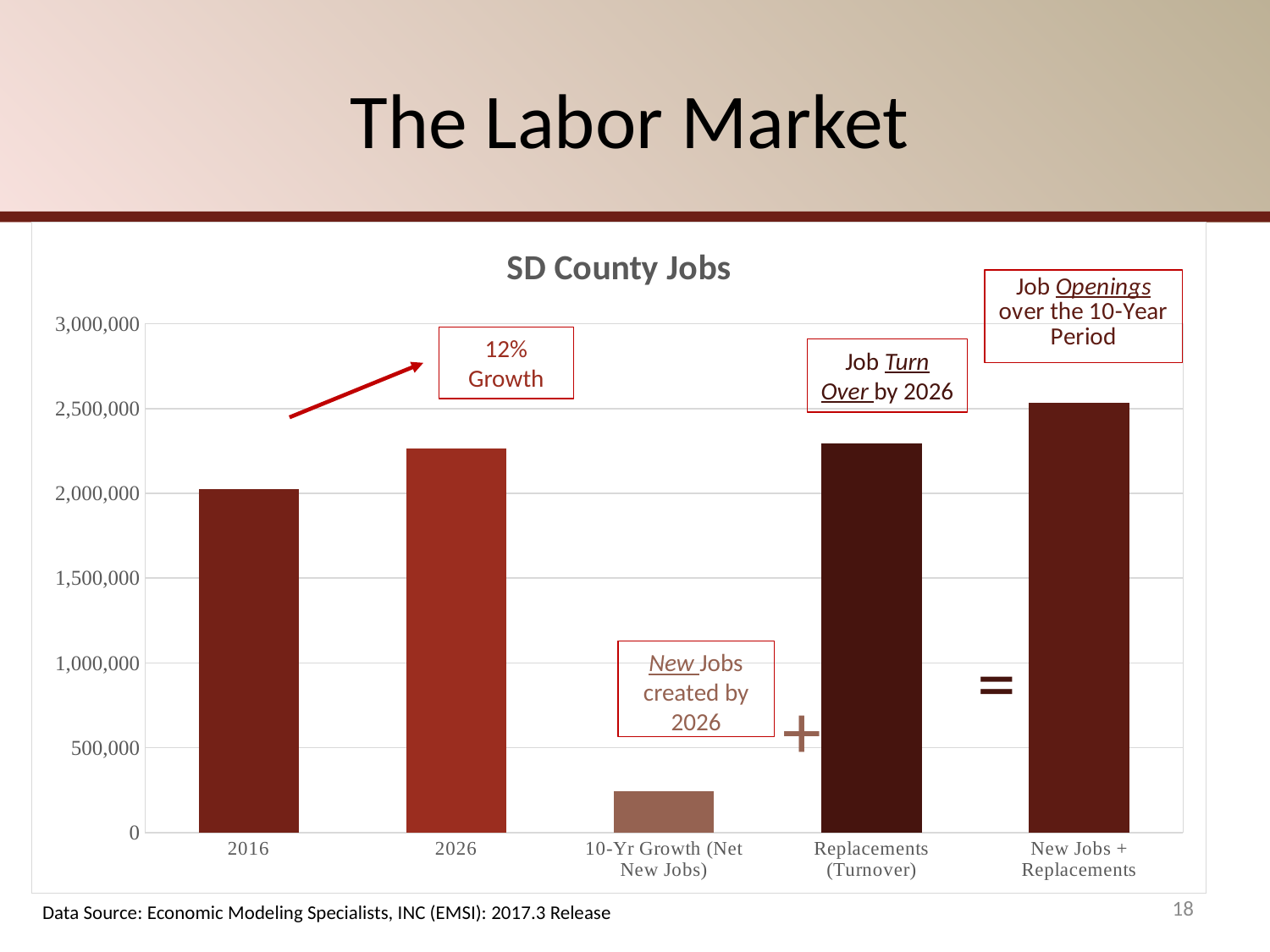
Is the value for 2026 greater or less than 2,500,000? less Is the value for 10-Yr Growth (Net New Jobs) greater or less than 500,000? less Which category has the highest value in the chart? New Jobs + Replacements What kind of chart is shown on the slide? bar chart What growth percentage does the annotation between the 2016 and 2026 bars state? 12% Growth Does the value rise or fall from 2016 to 2026? rise Is the value for Replacements (Turnover) greater or less than 2,000,000? greater Which is larger, the value for 2016 or the value for 2026? 2026 How many categories are shown on the x axis of the chart? 5 Which is larger, the value for 2016 or the value for Replacements (Turnover)? Replacements (Turnover) Which category has the lowest value in the chart? 10-Yr Growth (Net New Jobs) What is the title of the chart? SD County Jobs